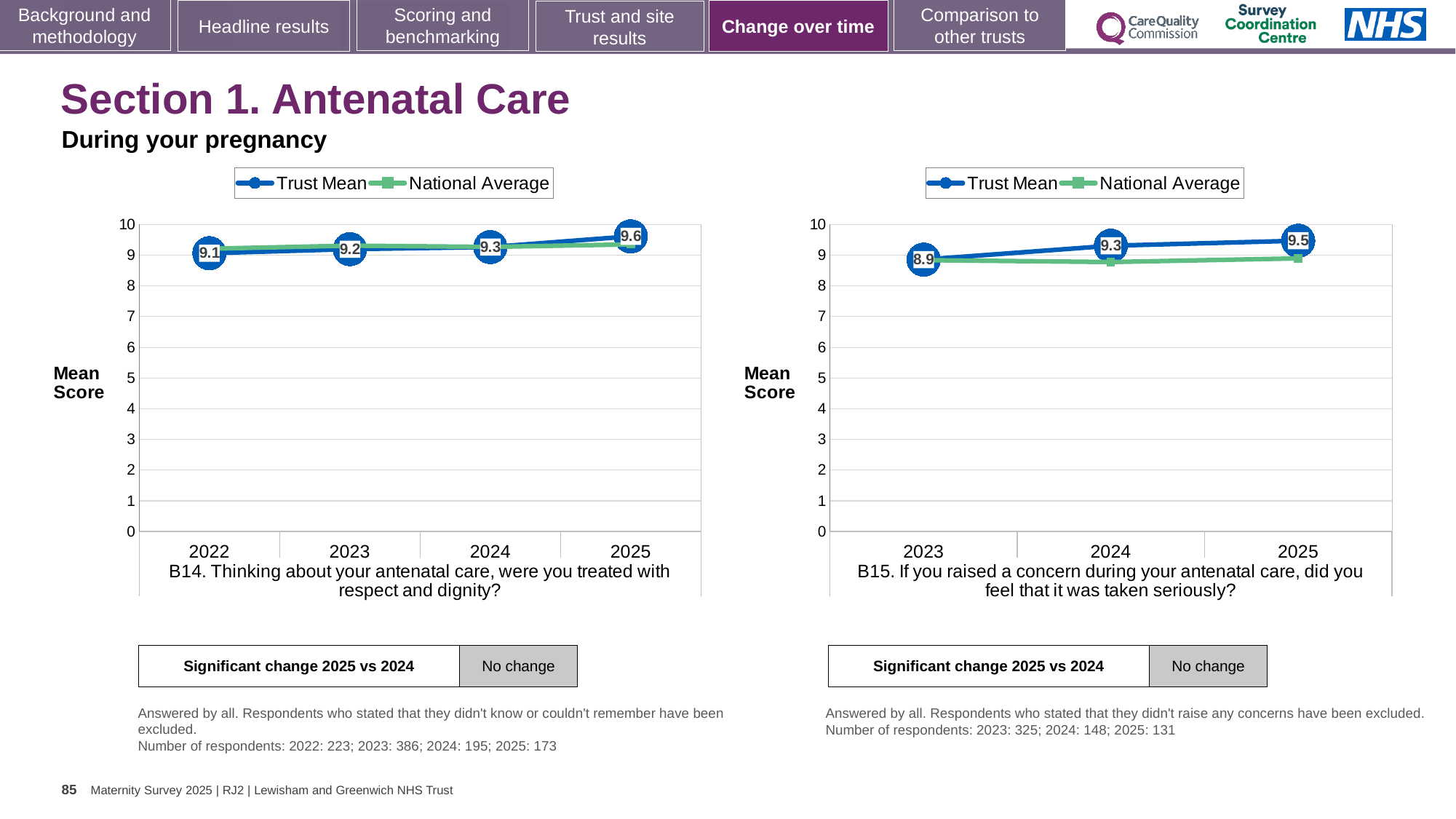
On the B15 chart (right), what is the Trust Mean score for 2025? 9.5 On the B15 chart (right), what is the difference between the Trust Mean scores for 2025 and 2023? 0.6 On the B14 chart (left), what is the Trust Mean score for 2025? 9.6 How many years are shown on the x axis of the B15 chart (right)? 3 On the B14 chart (left), what is the difference between the Trust Mean scores for 2025 and 2022? 0.5 What kind of chart is the B14 chart (left)? line chart On the B15 chart (right), what is the Trust Mean score for 2023? 8.9 On the B14 chart (left), does the Trust Mean rise or fall from 2022 to 2025? rise On the B15 chart (right), which year has the lowest Trust Mean score? 2023 How many series does the legend of the B14 chart (left) list? 2 On the B14 chart (left), what is the Trust Mean score for 2022? 9.1 On the B14 chart (left), which year has the highest Trust Mean score? 2025